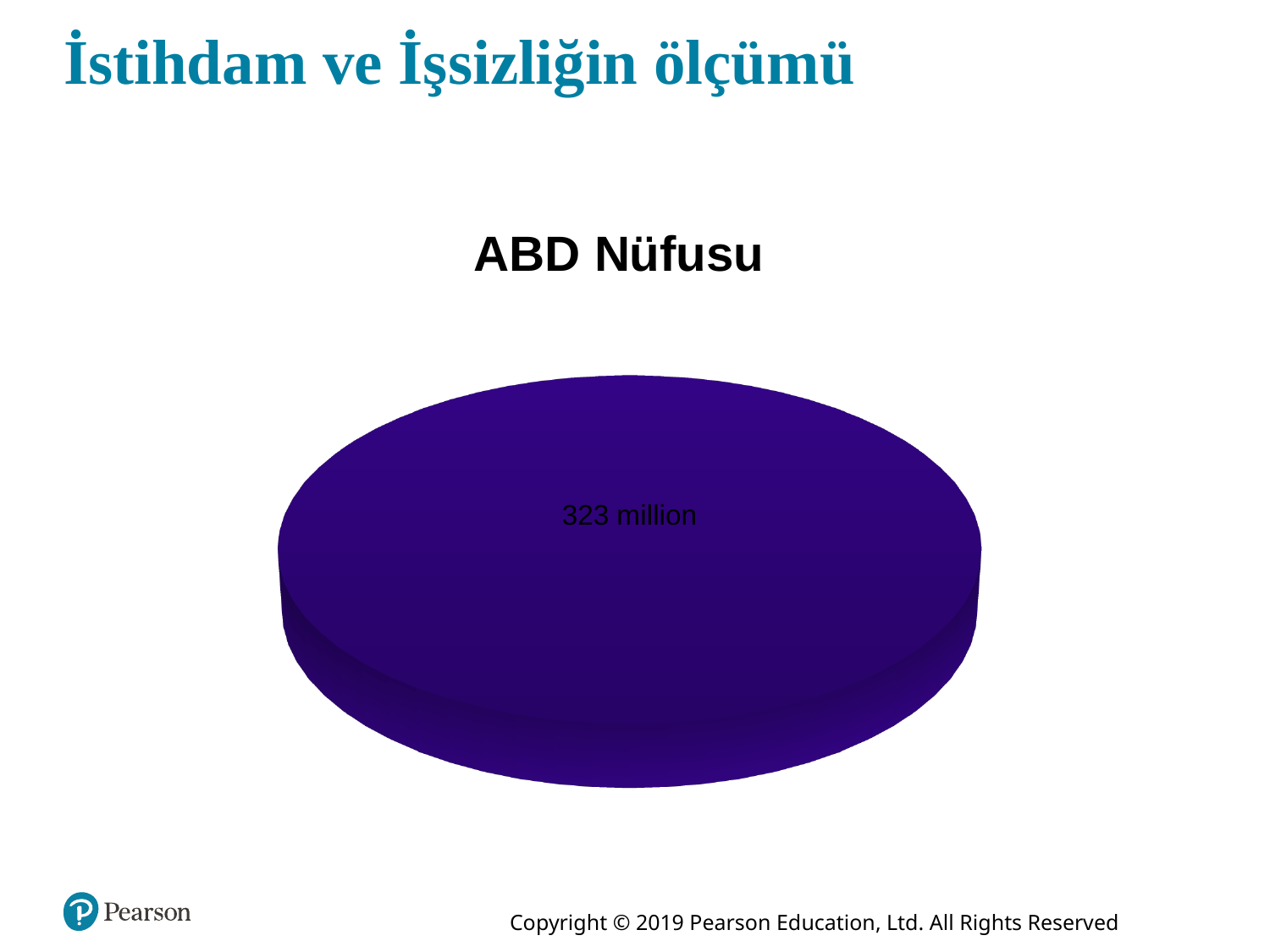
What kind of chart is shown on the slide? pie chart What value is labelled on the pie chart? 323 million How many slices does the pie chart have? 1 What is the title of the chart on the slide? ABD Nüfusu What share of the pie does the single slice represent? 100% What colour is the pie chart? purple